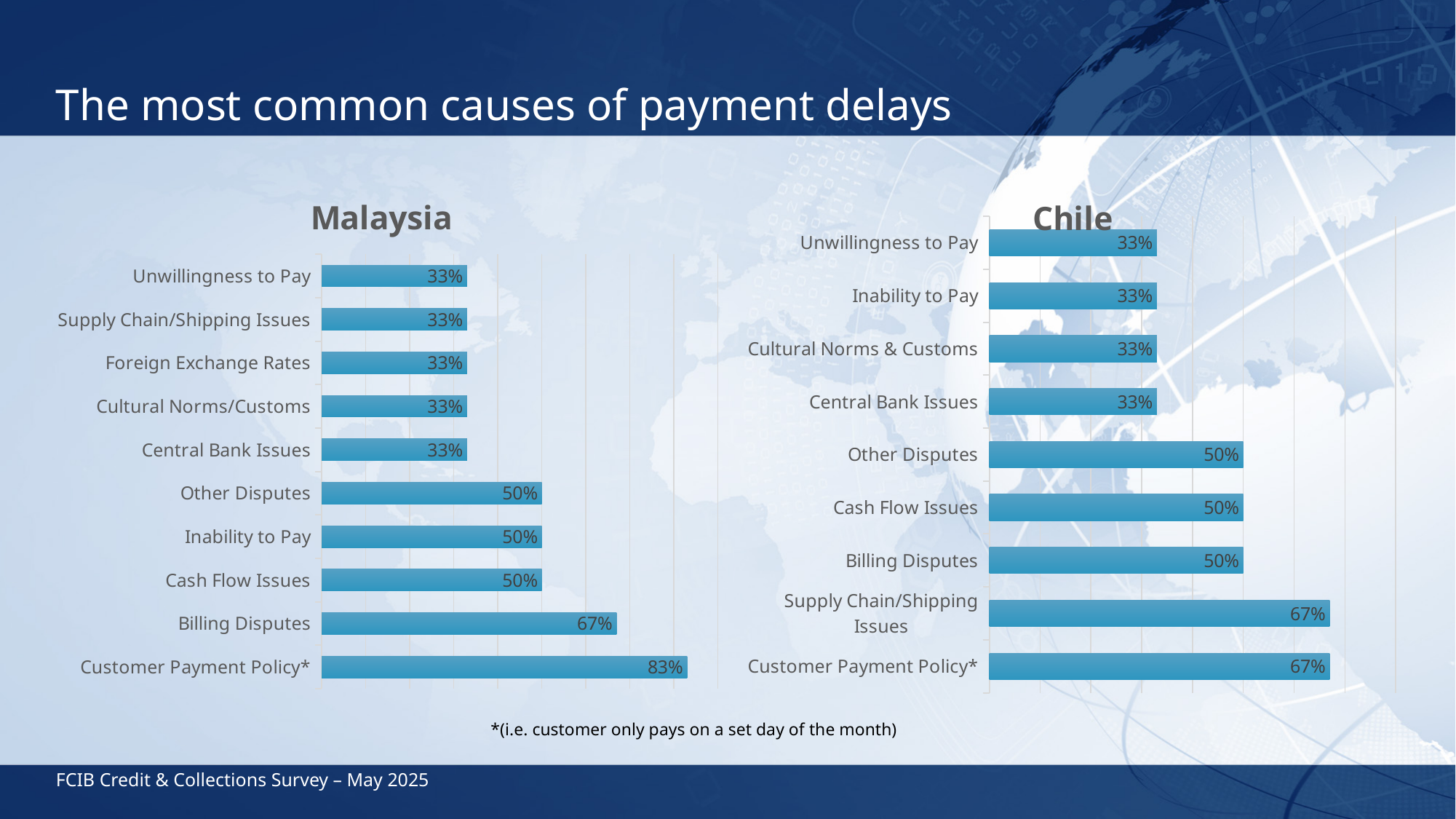
In the Malaysia chart, what is the value for Billing Disputes? 67% How many categories are shown in the Malaysia chart? 10 In the Chile chart, what is the value for Supply Chain/Shipping Issues? 67% In the Malaysia chart, which is larger: Cash Flow Issues or Central Bank Issues? Cash Flow Issues In the Malaysia chart, what is the value for Customer Payment Policy*? 83% How many categories are shown in the Chile chart? 9 In the Chile chart, what is the difference between Customer Payment Policy* and Unwillingness to Pay? 34% What type of chart is the Malaysia chart? Bar chart In the Chile chart, what is the value for Other Disputes? 50% Which is larger: Customer Payment Policy* in the Malaysia chart or Customer Payment Policy* in the Chile chart? Malaysia In the Malaysia chart, which category has the highest value? Customer Payment Policy* In the Malaysia chart, what is the difference between Customer Payment Policy* and Billing Disputes? 16%